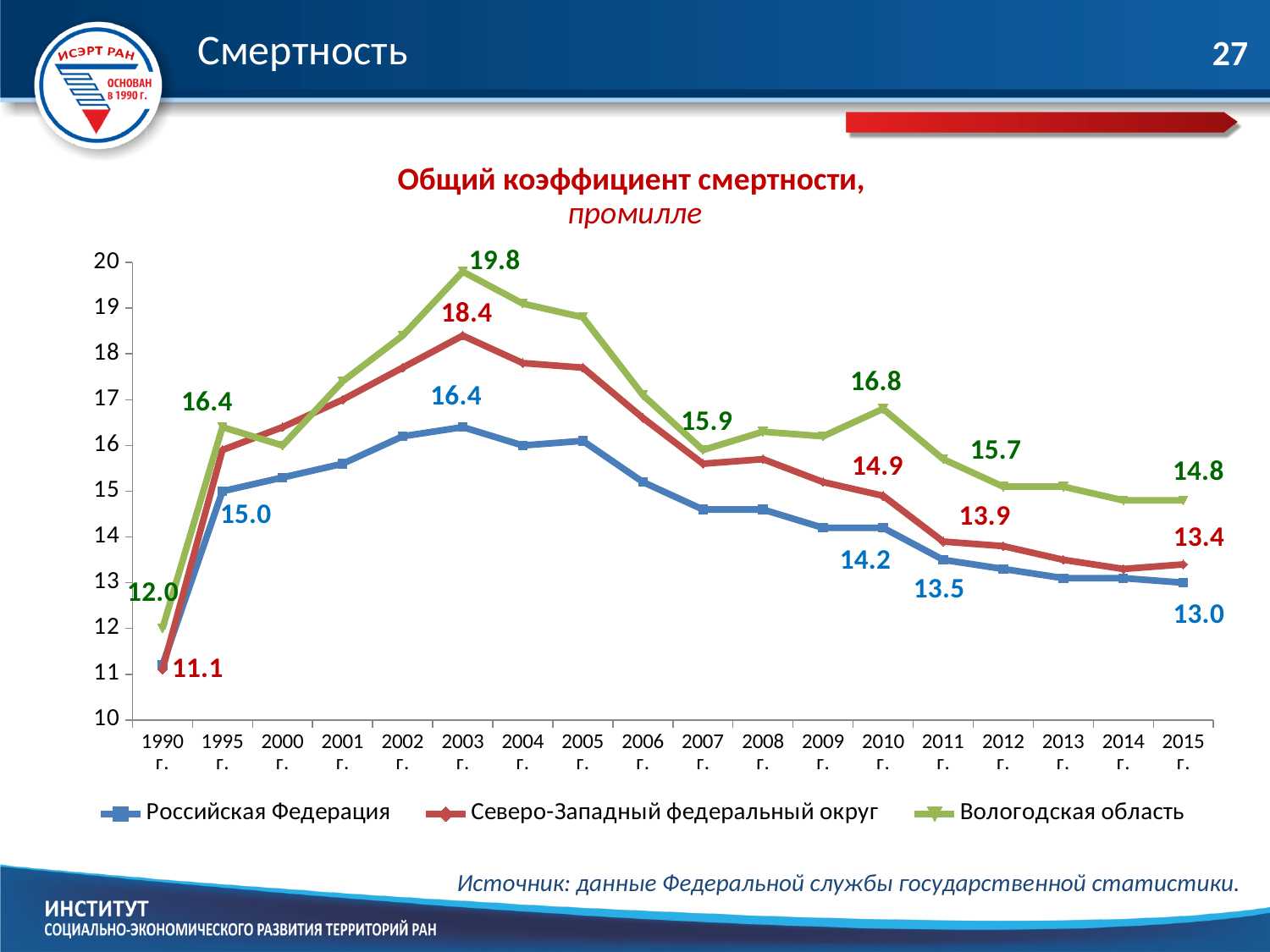
Is the value for Вологодская область in 2005 greater or less than 18? greater What is the value for Российская Федерация in 2015? 13.0 How many years are shown on the x axis? 18 What is the value for Вологодская область in 2010? 16.8 What kind of chart is shown on the slide? line chart What is the value for Северо-Западный федеральный округ in 1990? 11.1 How many series does the legend list? 3 By how much did the Северо-Западный федеральный округ value fall from 2010 to 2011? 1.0 What is the value for Вологодская область in 2003? 19.8 What is the difference between the Вологодская область and Северо-Западный федеральный округ values in 2003? 1.4 In which year does the Вологодская область series reach its highest value? 2003 In 2015, which is larger: Вологодская область or Российская Федерация? Вологодская область